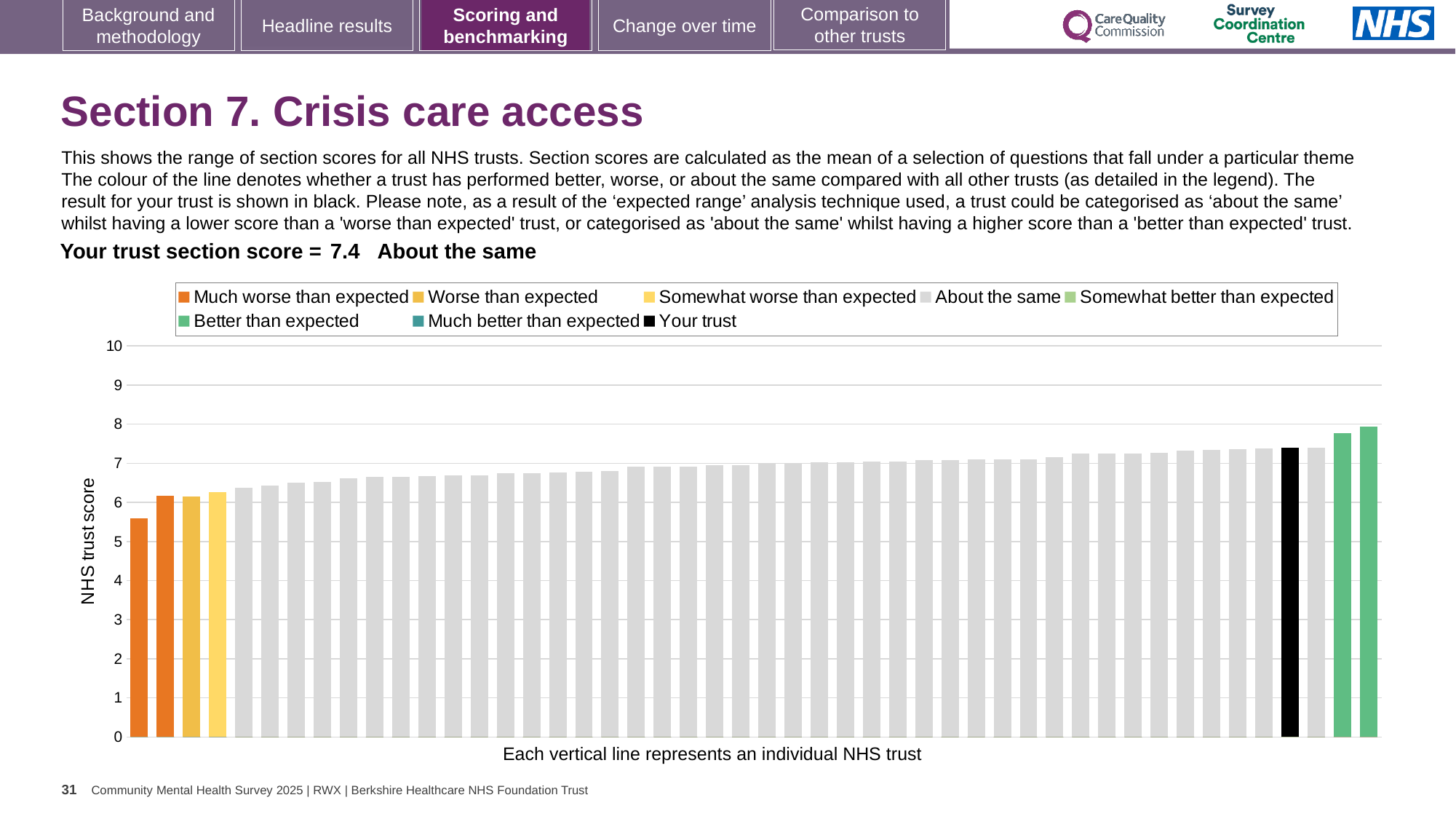
Is the value of the rightmost bar greater or less than 7? greater What is the label on the y axis of the chart? NHS trust score Is the value of the black 'Your trust' bar greater or less than 7? greater Which is larger: the value of the black 'Your trust' bar or the value of the leftmost orange bar? Your trust What kind of chart is shown on the slide? bar chart What is the section score for your trust shown on the slide? 7.4 Is the value of the leftmost bar greater or less than 5? greater What colour is the bar representing your trust? black How many entries does the chart legend list? 8 Do the bar values rise or fall from left to right along the x axis? rise